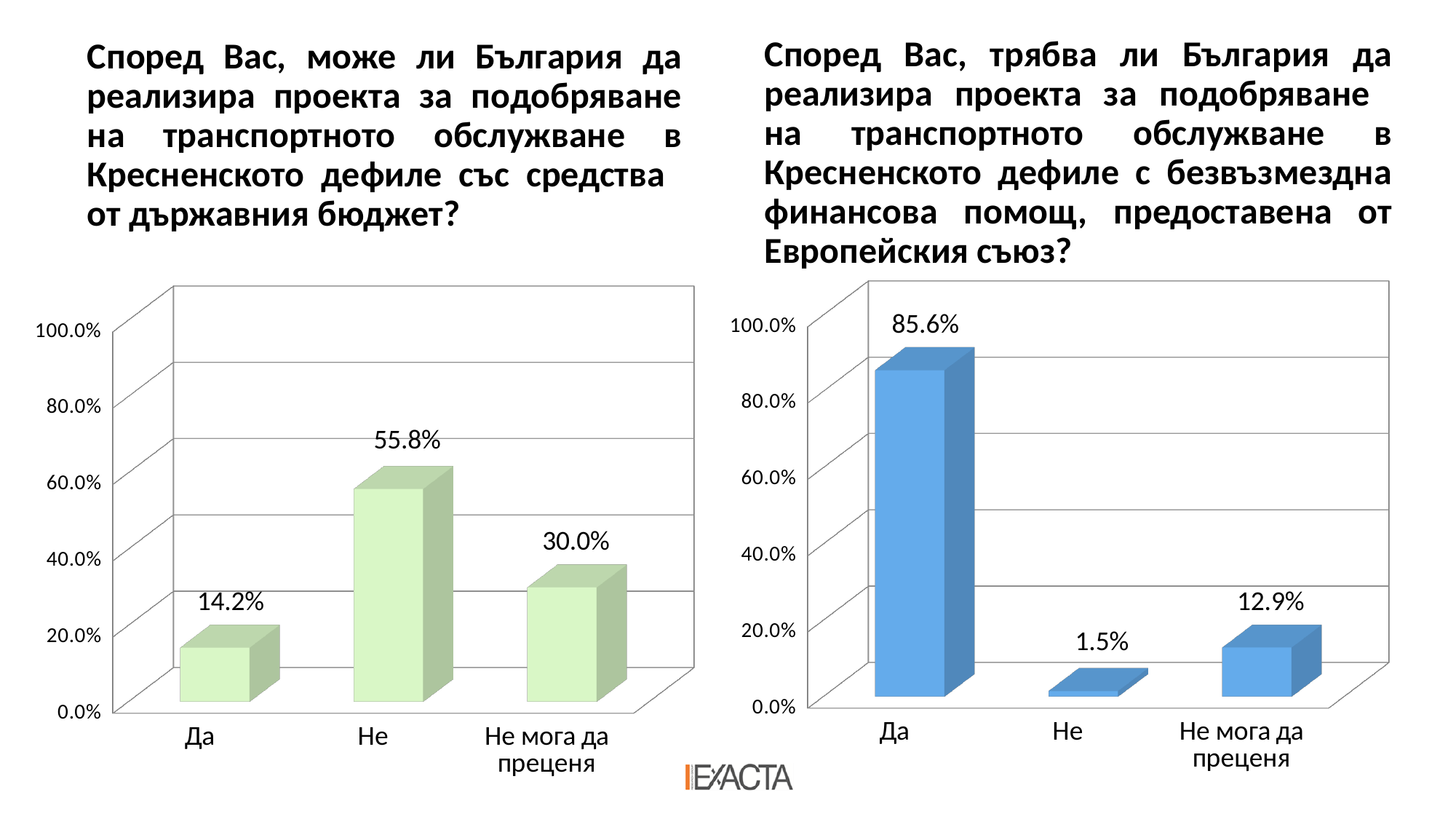
What type of chart is the right chart (EU funding question)? Bar chart In the right chart (EU funding question), what is the value for "Не"? 1.5% What colour are the bars in the left chart (state budget question)? Light green In the left chart (state budget question), which category has the highest value? Не In the right chart (EU funding question), which category has the lowest value? Не Which is larger: the value for "Да" in the left chart or the value for "Да" in the right chart? The right chart (85.6%) In the left chart (state budget question), what is the difference between the values for "Не" and "Не мога да преценя"? 25.8% How many categories are shown in the left chart (state budget question)? 3 In the left chart (state budget question), what is the value for "Да"? 14.2% In the right chart (EU funding question), what is the value for "Да"? 85.6% In the left chart (state budget question), what is the value for "Не"? 55.8% In the right chart (EU funding question), what is the difference between the values for "Да" and "Не мога да преценя"? 72.7%